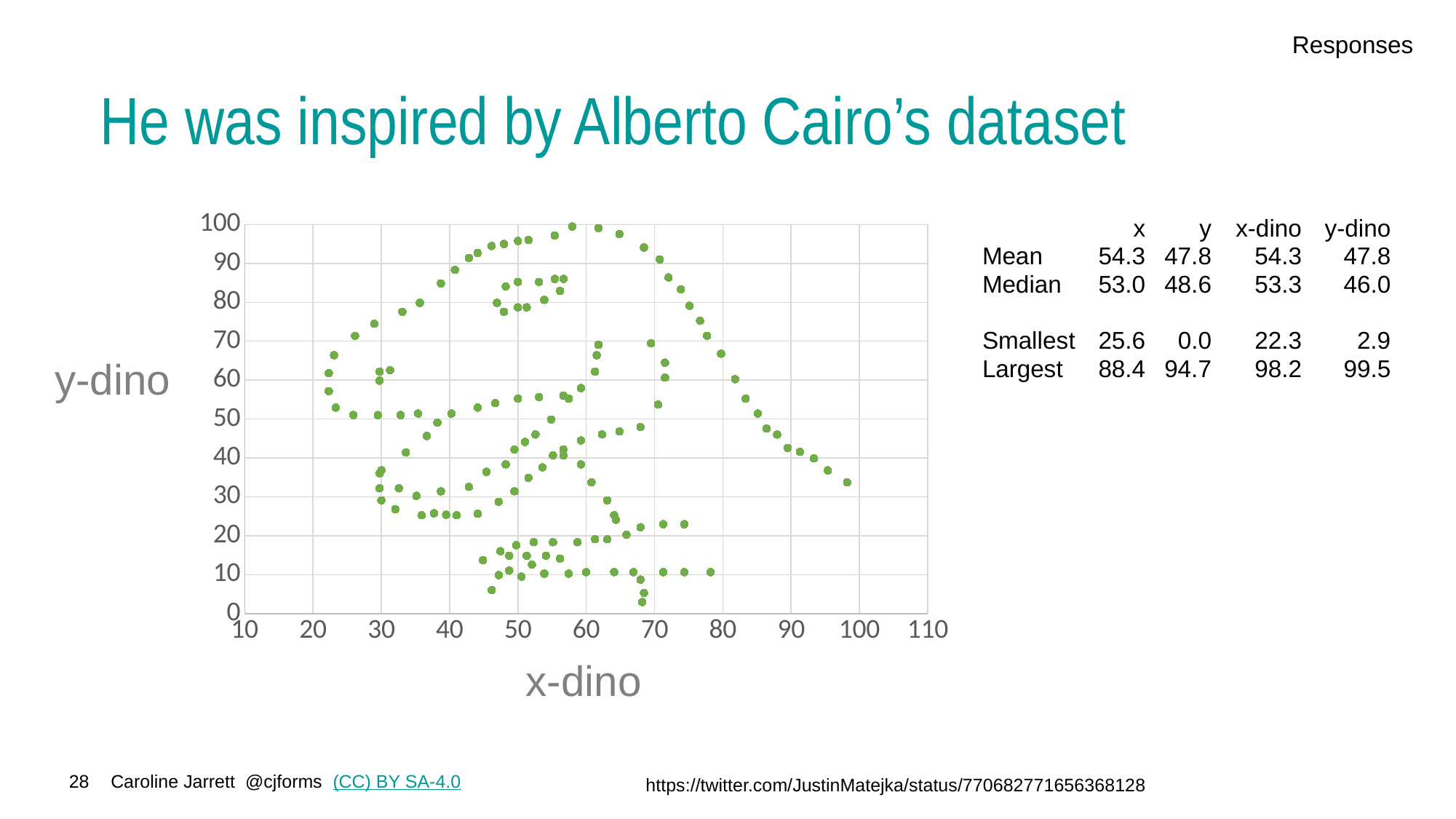
According to the table beside the chart, what is the smallest x-dino value? 22.3 Is the smallest x-dino value plotted in the chart greater or less than 30? less Is the largest x-dino value plotted in the chart greater or less than 90? greater Using the table beside the chart, what is the difference between the largest and smallest x-dino values? 75.9 According to the table beside the chart, what is the median of y-dino? 46.0 What kind of chart is shown on the slide? scatter plot Is the smallest y-dino value plotted in the chart greater or less than 10? less According to the table beside the chart, what is the largest y-dino value? 99.5 What is the label on the horizontal axis of the chart? x-dino What is the label on the vertical axis of the chart? y-dino According to the table beside the chart, which has the larger mean, x-dino or y-dino? x-dino According to the table beside the chart, what is the mean of x-dino? 54.3